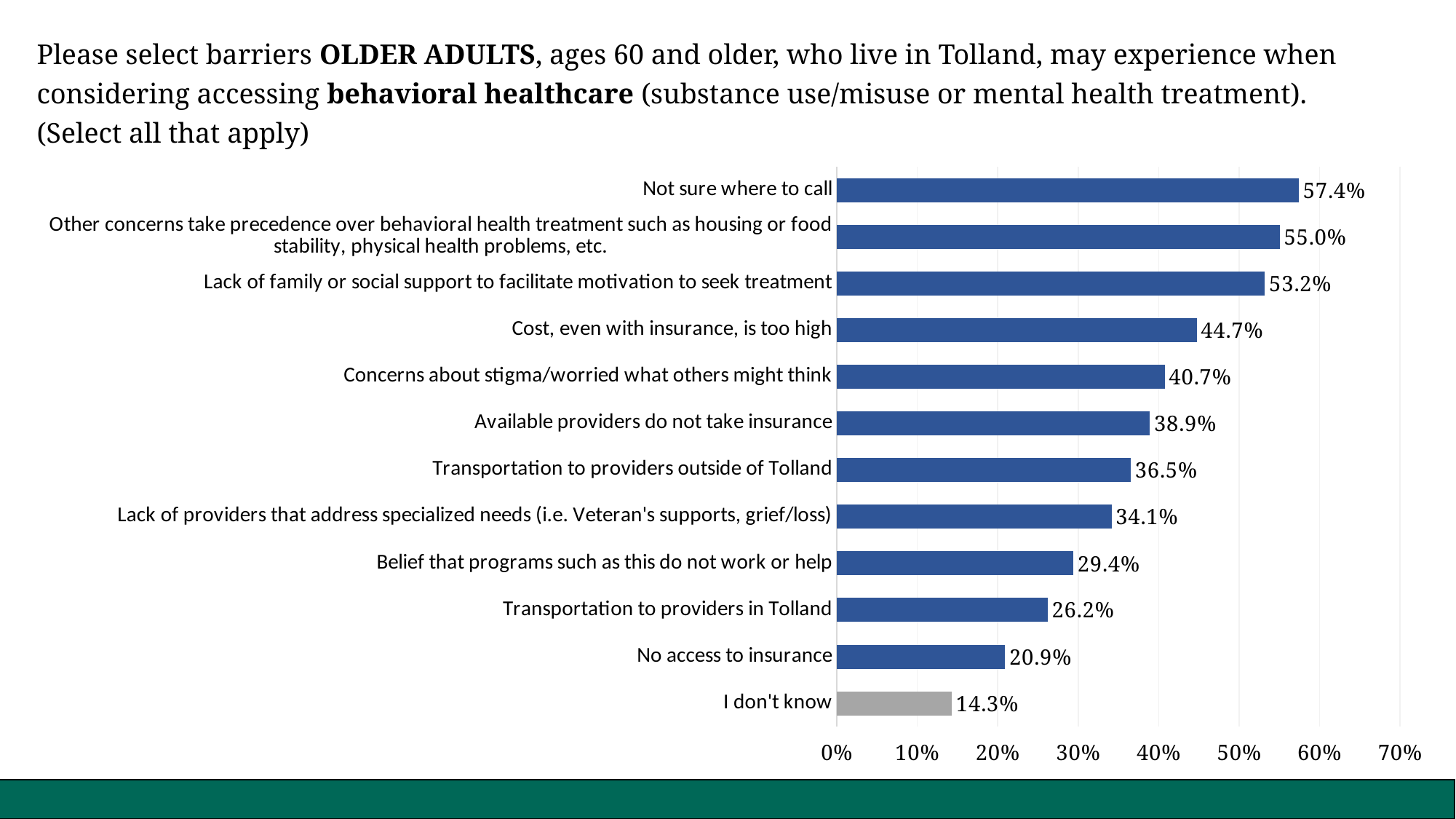
How many categories are shown in the chart? 12 What is the difference between "Not sure where to call" and "No access to insurance"? 36.5% What percentage selected "Transportation to providers in Tolland"? 26.2% Is the value for "Concerns about stigma/worried what others might think" greater or less than 30%? greater What is the value for "Cost, even with insurance, is too high"? 44.7% What is the difference between "Lack of family or social support to facilitate motivation to seek treatment" and "Belief that programs such as this do not work or help"? 23.8% Which barrier has the highest percentage? Not sure where to call Which category has the lowest percentage? I don't know What kind of chart is shown on the slide? Bar chart What percentage selected "Not sure where to call" as a barrier? 57.4% Which bar is shown in a different colour (grey) from the others? I don't know Which is larger: "Available providers do not take insurance" or "Transportation to providers outside of Tolland"? Available providers do not take insurance